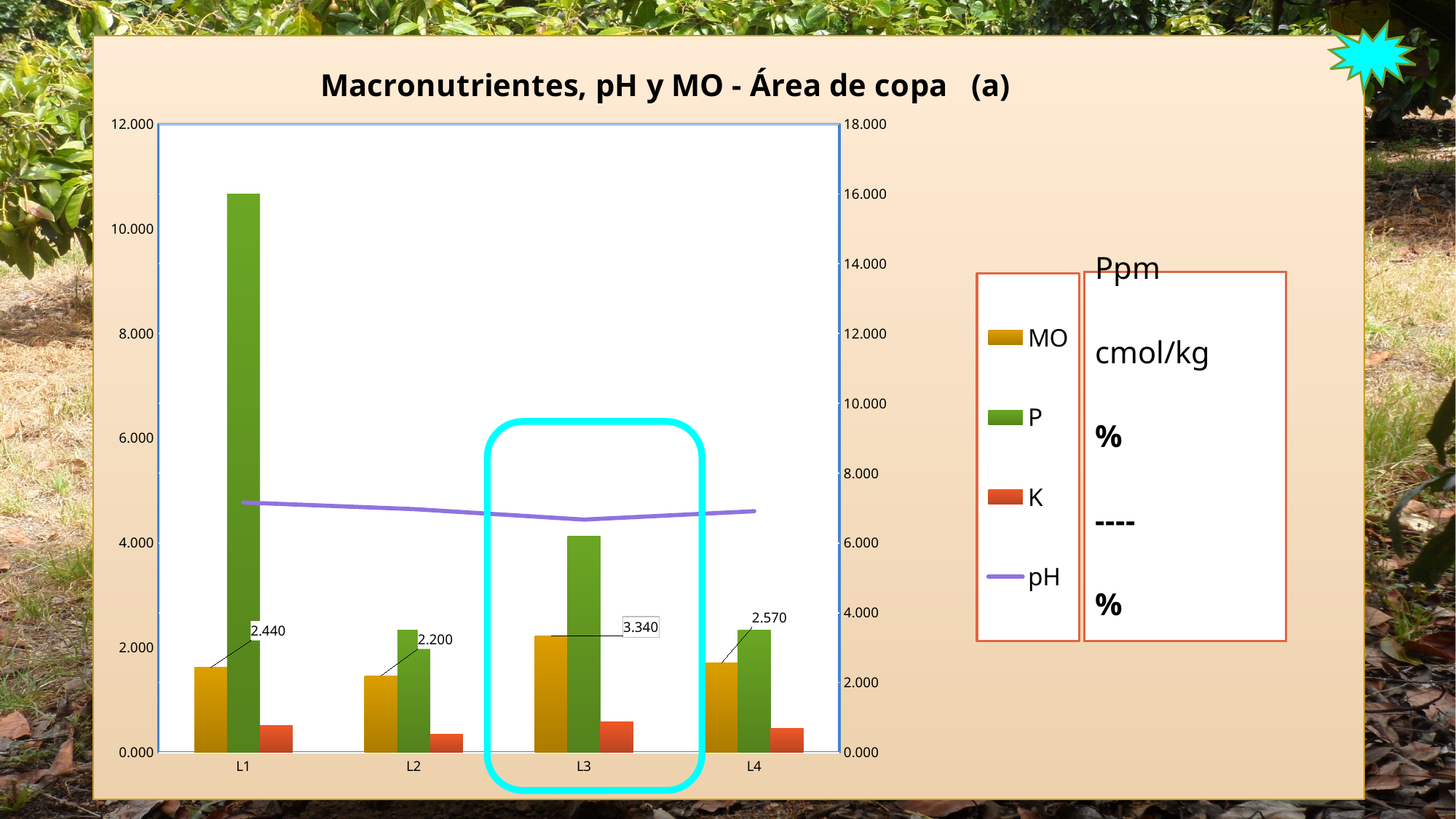
What is the data label shown for MO at L4? 2.570 Which is larger, the MO value at L4 or at L2? L4 What is the data label shown for MO at L2? 2.200 How many series does the legend list? 4 Which category has the highest labelled MO value? L3 What is the data label shown for MO at L1? 2.440 How many categories are shown on the x axis? 4 What is the title of the chart? Macronutrientes, pH y MO - Área de copa (a) What is the difference between the MO values at L3 and L1? 0.900 What is the data label shown for MO at L3? 3.340 Which category has the lowest labelled MO value? L2 Which category has the tallest P bar? L1